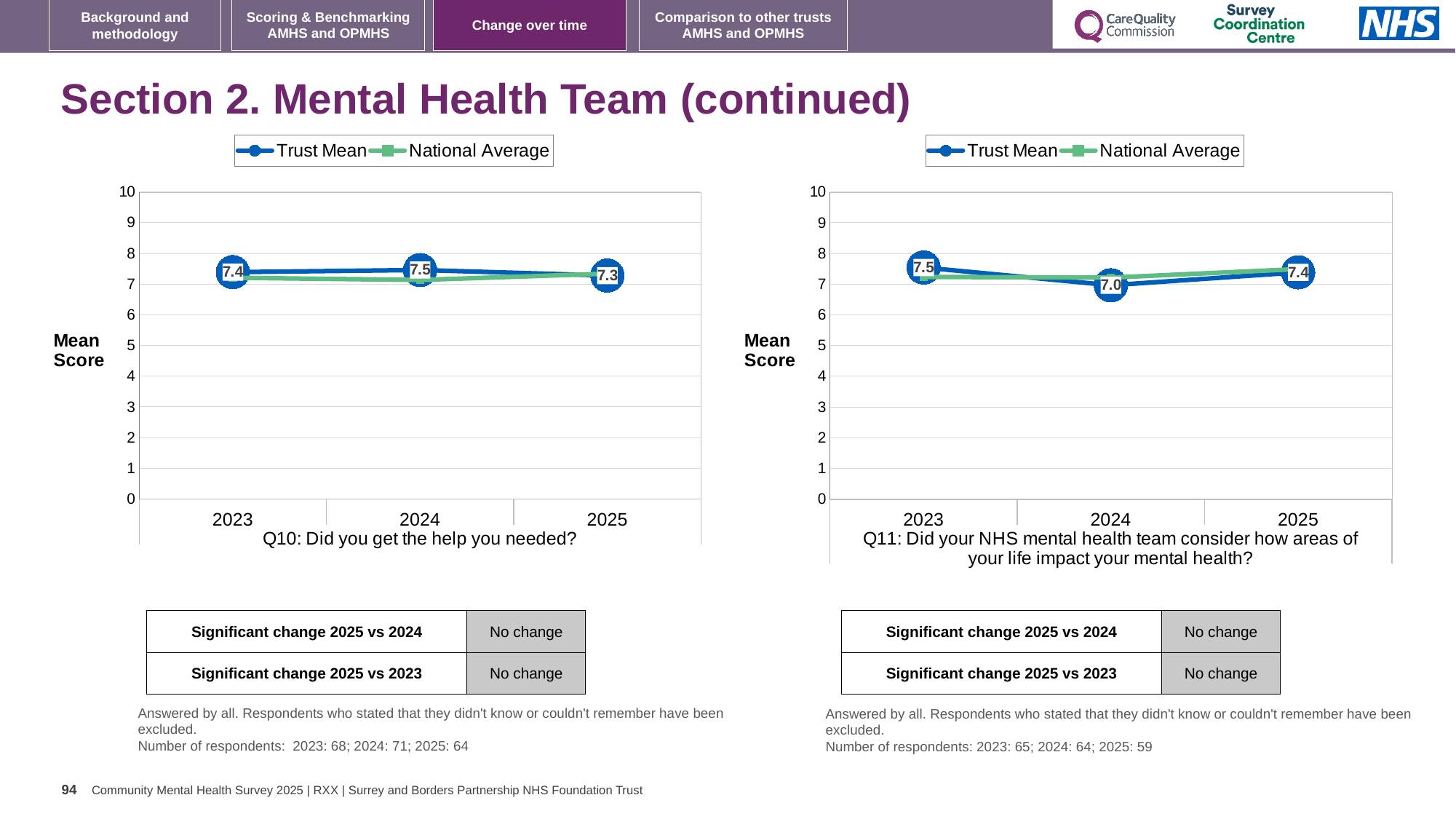
In the Q11 chart, is the National Average value for 2024 greater or less than 5? greater In the Q11 chart, what is the Trust Mean score for 2024? 7.0 In the Q11 chart, what is the difference between the Trust Mean scores for 2023 and 2024? 0.5 In the Q10 chart, which year has the highest Trust Mean score? 2024 In the Q11 chart, which year has the lowest Trust Mean score? 2024 What type of chart is used for Q10? Line chart In the Q10 chart, what is the Trust Mean score for 2025? 7.3 How many series does the legend of the Q11 chart list? 2 How many years are shown on the x axis of the Q10 chart? 3 In the Q10 chart, is the Trust Mean score higher in 2023 or in 2025? 2023 In the Q10 chart, what is the Trust Mean score for 2024? 7.5 In the Q11 chart, does the Trust Mean rise or fall from 2024 to 2025? Rise